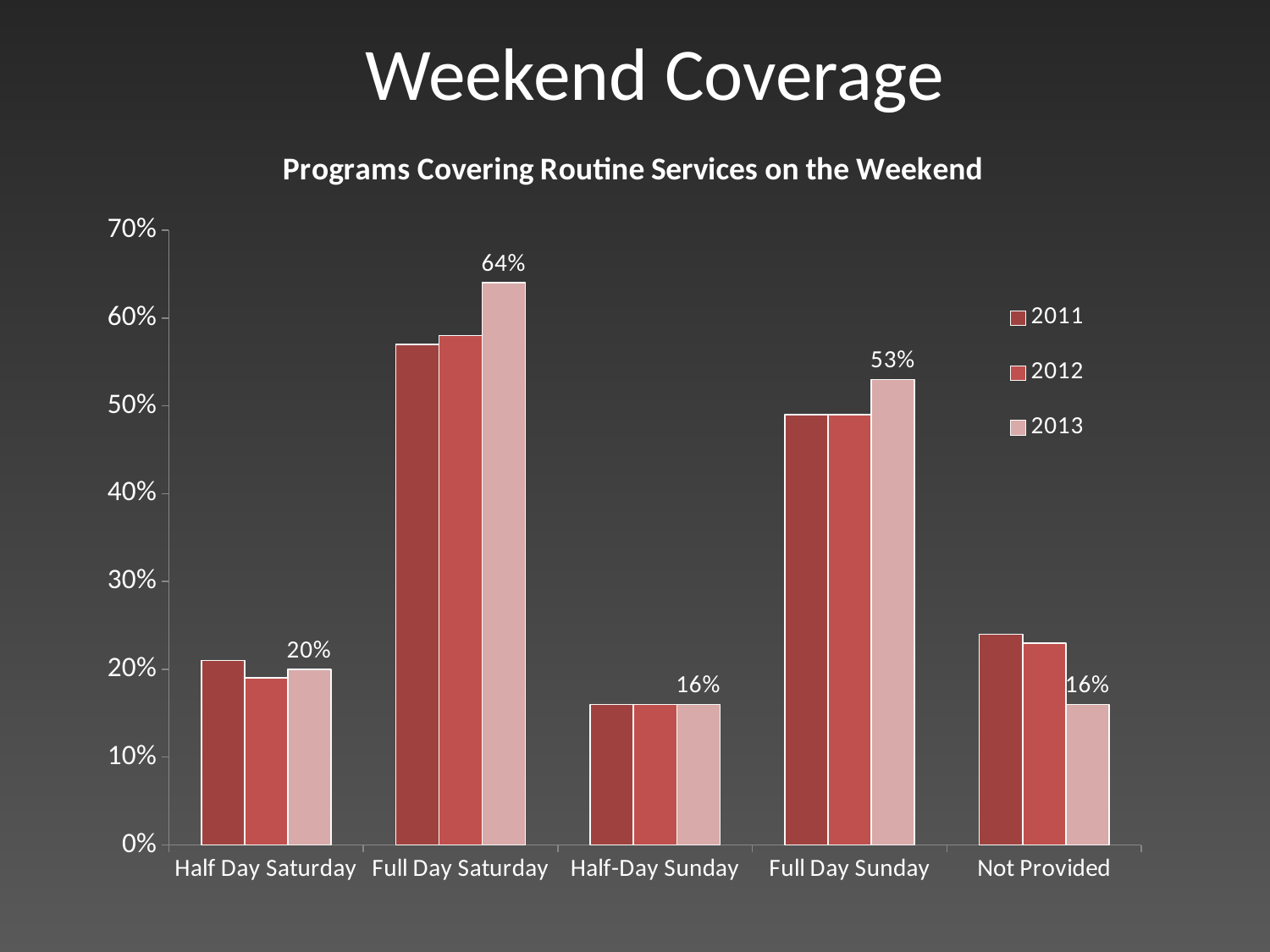
What kind of chart is shown on the slide? bar chart What is the value for 2013 in the Full Day Sunday category? 53% Which category has the highest 2013 value? Full Day Saturday What is the value for 2013 in the Half Day Saturday category? 20% How many series does the legend list? 3 What is the value for 2013 in the Not Provided category? 16% Is the 2011 value for Full Day Saturday greater or less than 50%? greater What is the value for 2013 in the Full Day Saturday category? 64% Which is larger for 2013: Full Day Saturday or Full Day Sunday? Full Day Saturday What is the difference between the 2013 values for Full Day Saturday and Full Day Sunday? 11% How many categories are shown on the x axis? 5 Is the 2011 value for Not Provided greater or less than 30%? less